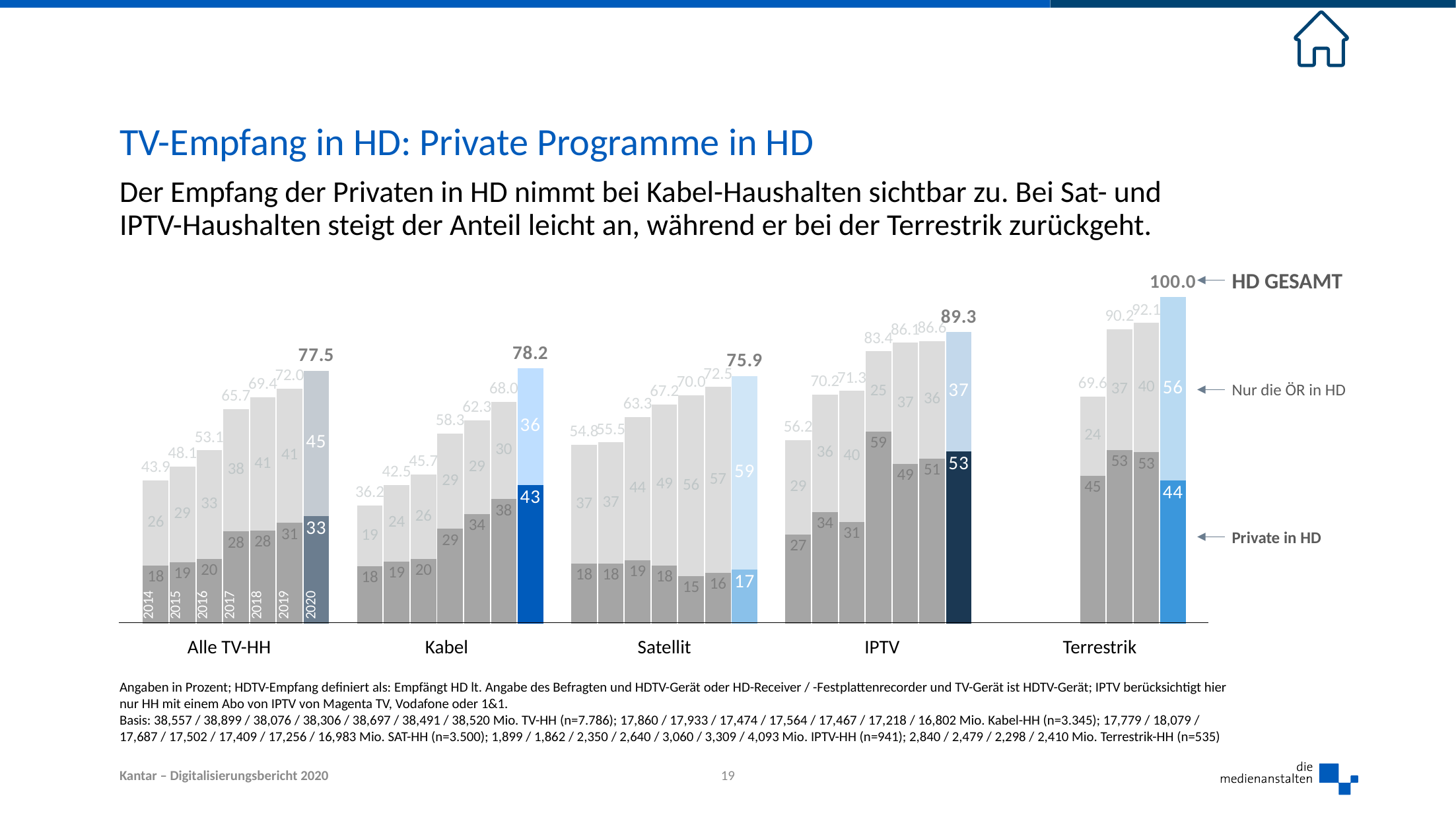
What is the 'Nur die ÖR in HD' value for Satellit in 2020? 59 How many reception-type groups are shown on the x axis? 5 What is the HD GESAMT value for Terrestrik in 2020? 100.0 Which is larger in 2020: the 'Private in HD' value for Kabel or for Terrestrik? Terrestrik What is the HD GESAMT value for Kabel in 2020? 78.2 How many years are shown for the Alle TV-HH group? 7 What is the difference between the 2020 HD GESAMT values for IPTV and Alle TV-HH? 11.8 Which reception type has the highest HD GESAMT value in 2020? Terrestrik What kind of chart is shown on the slide? Stacked bar chart Does the HD GESAMT value for Kabel rise or fall from 2014 to 2020? Rise What is the 'Private in HD' value for IPTV in 2020? 53 Which reception type has the lowest 'Private in HD' value in 2020? Satellit